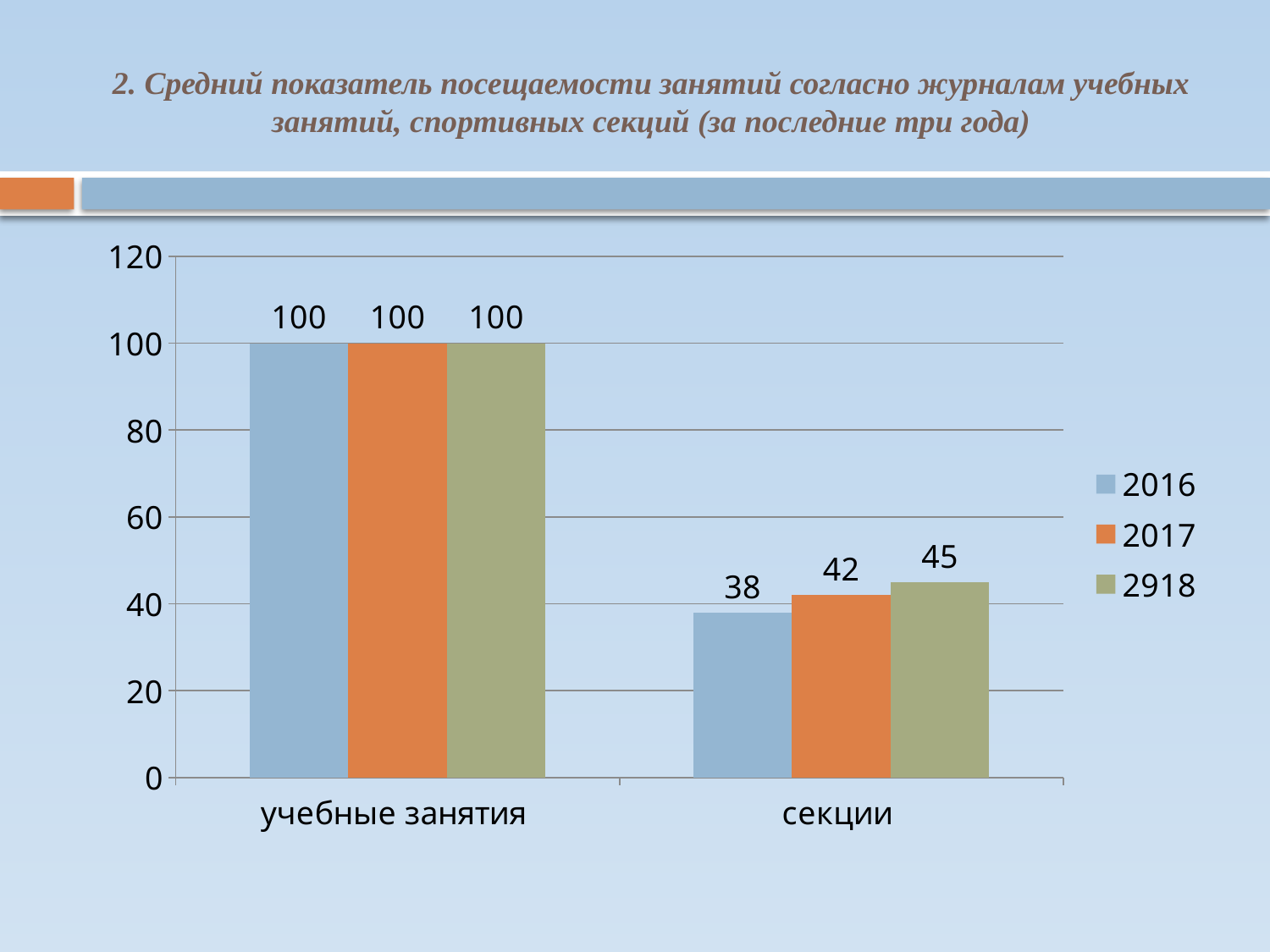
What is the difference between the 2918 and 2016 values in the секции category? 7 What is the value for the 2918 series in the секции category? 45 What is the value for 2016 in the секции category? 38 What is the value for 2017 in the секции category? 42 How many categories are shown on the x axis? 2 Which series has the highest value in the секции category? 2918 Which series has the lowest value in the секции category? 2016 Which is larger in the секции category: the 2017 value or the 2016 value? 2017 What are the three legend entries? 2016, 2017, 2918 What kind of chart is shown on the slide? bar chart How many series does the legend list? 3 What is the value for 2016 in the учебные занятия category? 100